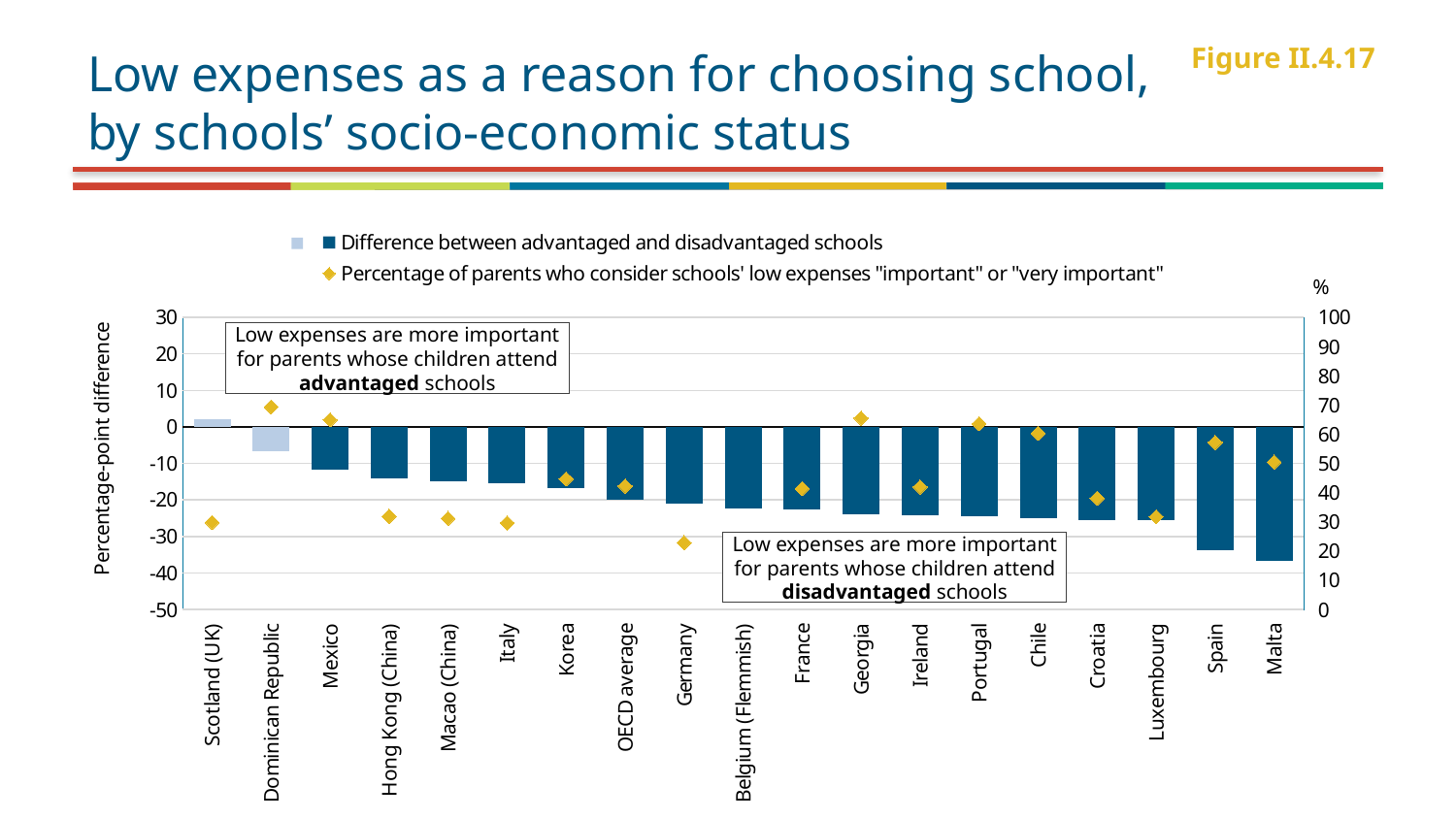
How many series does the legend list? 2 Which category has the highest bar for the difference between advantaged and disadvantaged schools? Scotland (UK) What kind of chart is shown on the slide? combination chart (bars with diamond markers) What is the figure number shown on the slide? Figure II.4.17 How many countries or economies (including the OECD average) are shown along the x axis? 19 Is the percentage of parents (diamond marker) for Germany greater or less than 30%? less Which has the larger bar value for the difference between advantaged and disadvantaged schools, Mexico or Malta? Mexico Do the bar values for the difference between advantaged and disadvantaged schools generally rise or fall from left to right along the x axis? fall Is the percentage of parents (diamond marker) for Georgia greater or less than 60%? greater Is the bar value for Scotland (UK) greater or less than 0? greater